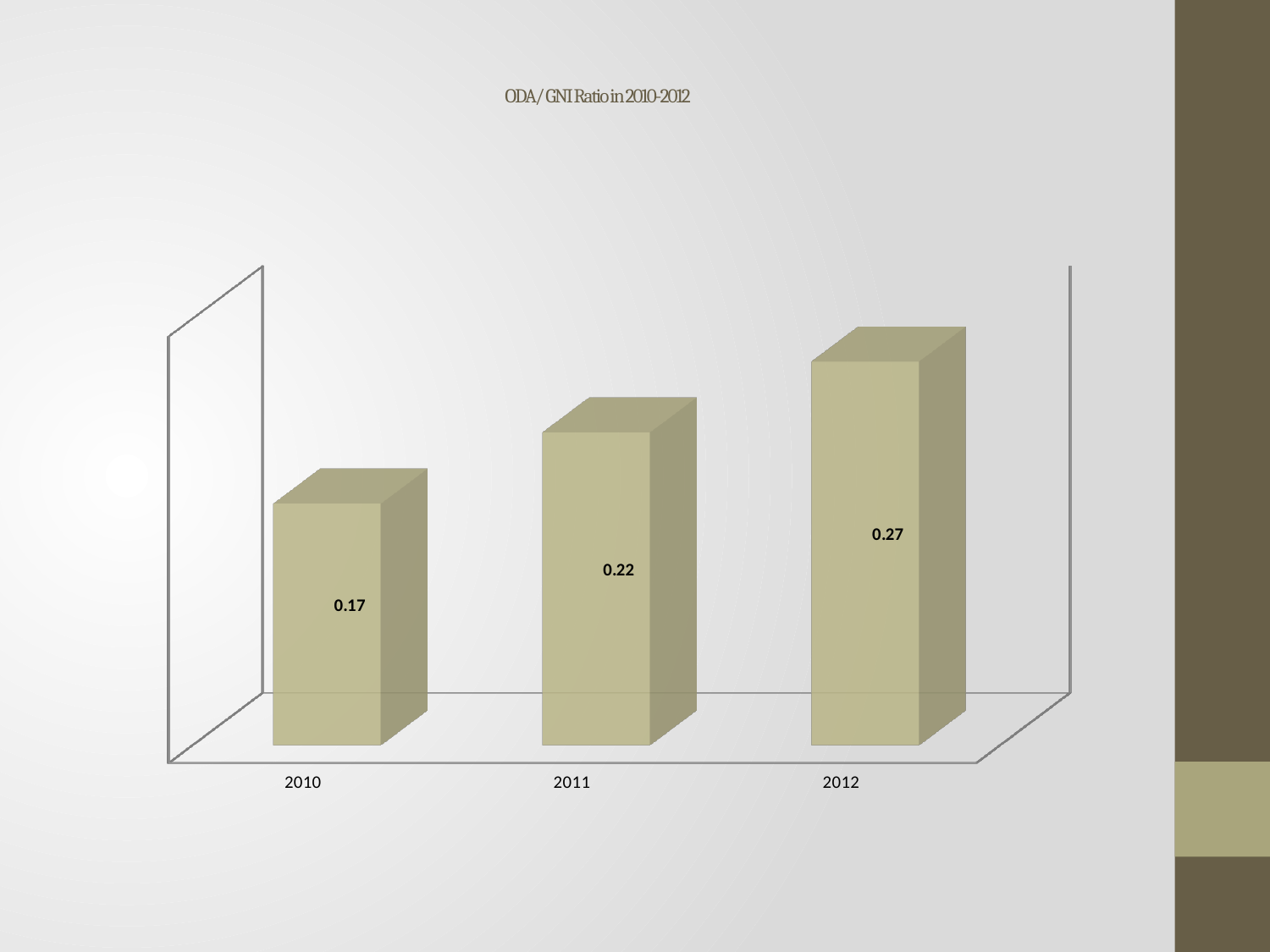
What is the difference between the ODA/GNI ratio in 2012 and in 2010? 0.10 What is the ODA/GNI ratio for 2010? 0.17 Which year has the highest ODA/GNI ratio? 2012 What is the ODA/GNI ratio for 2012? 0.27 Which year has the lowest ODA/GNI ratio? 2010 What is the title of the chart? ODA/GNI Ratio in 2010-2012 Does the ODA/GNI ratio rise or fall from 2010 to 2012? Rise Which year has a larger ODA/GNI ratio, 2011 or 2012? 2012 What kind of chart is shown on the slide? Bar chart How many years are shown on the chart? 3 What is the ODA/GNI ratio for 2011? 0.22 What is the difference between the ODA/GNI ratio in 2011 and in 2010? 0.05